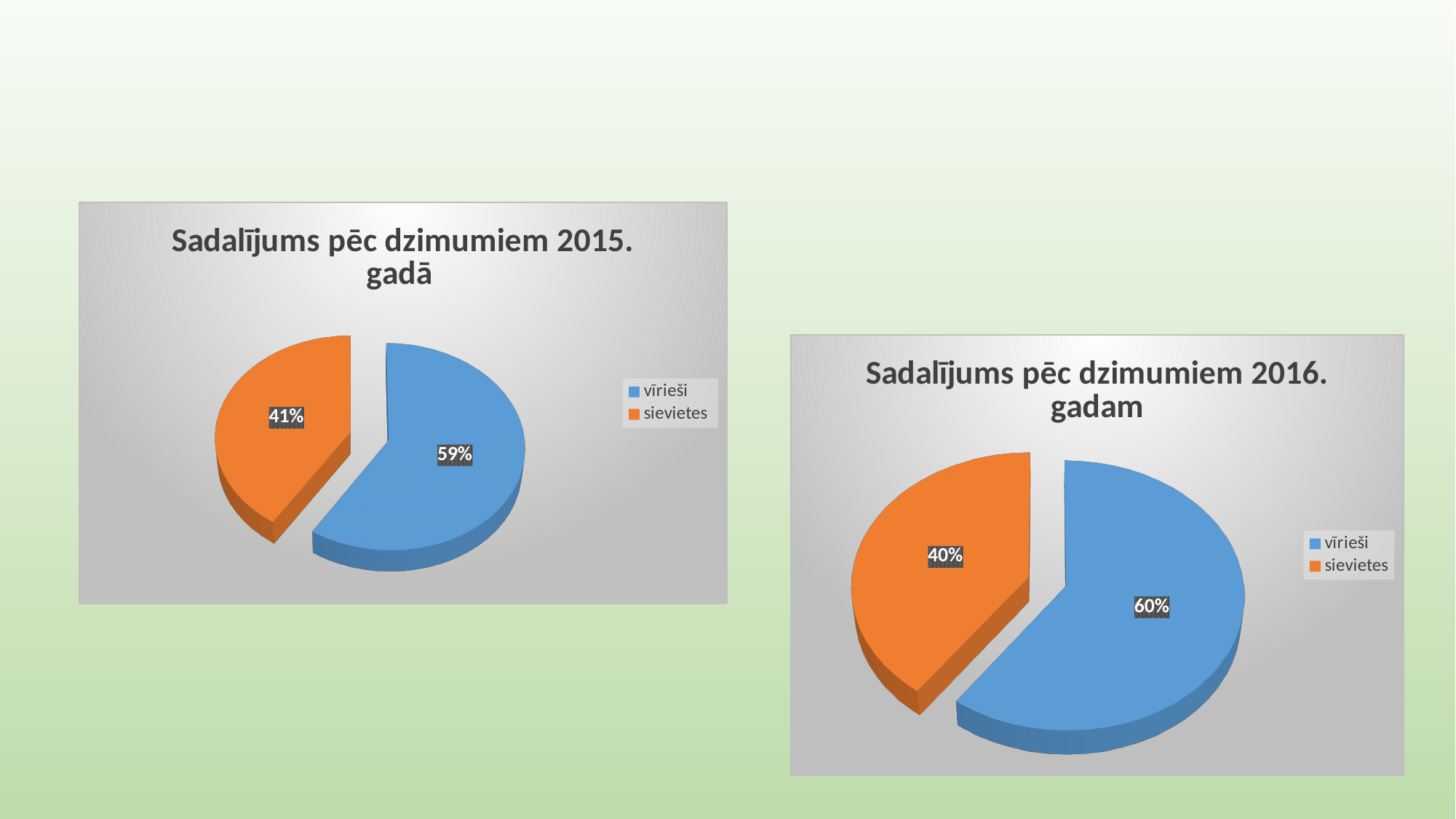
In the chart titled "Sadalījums pēc dzimumiem 2016. gadam", which is larger, vīrieši or sievietes? vīrieši How many categories does the chart titled "Sadalījums pēc dzimumiem 2015. gadā" show? 2 In the chart titled "Sadalījums pēc dzimumiem 2015. gadā", which category has the largest slice? vīrieši In the chart titled "Sadalījums pēc dzimumiem 2016. gadam", what is the difference in percentage points between vīrieši and sievietes? 20 In the chart titled "Sadalījums pēc dzimumiem 2016. gadam", what share of the pie is vīrieši? 60% In the chart titled "Sadalījums pēc dzimumiem 2016. gadam", what share of the pie is sievietes? 40% What kind of chart is the chart on the left of the slide? pie chart In the chart titled "Sadalījums pēc dzimumiem 2016. gadam", what colour is the sievietes slice? orange In the chart titled "Sadalījums pēc dzimumiem 2015. gadā", what is the difference in percentage points between vīrieši and sievietes? 18 In the chart titled "Sadalījums pēc dzimumiem 2016. gadam", which category has the smallest slice? sievietes In the chart titled "Sadalījums pēc dzimumiem 2015. gadā", what share of the pie is vīrieši? 59%